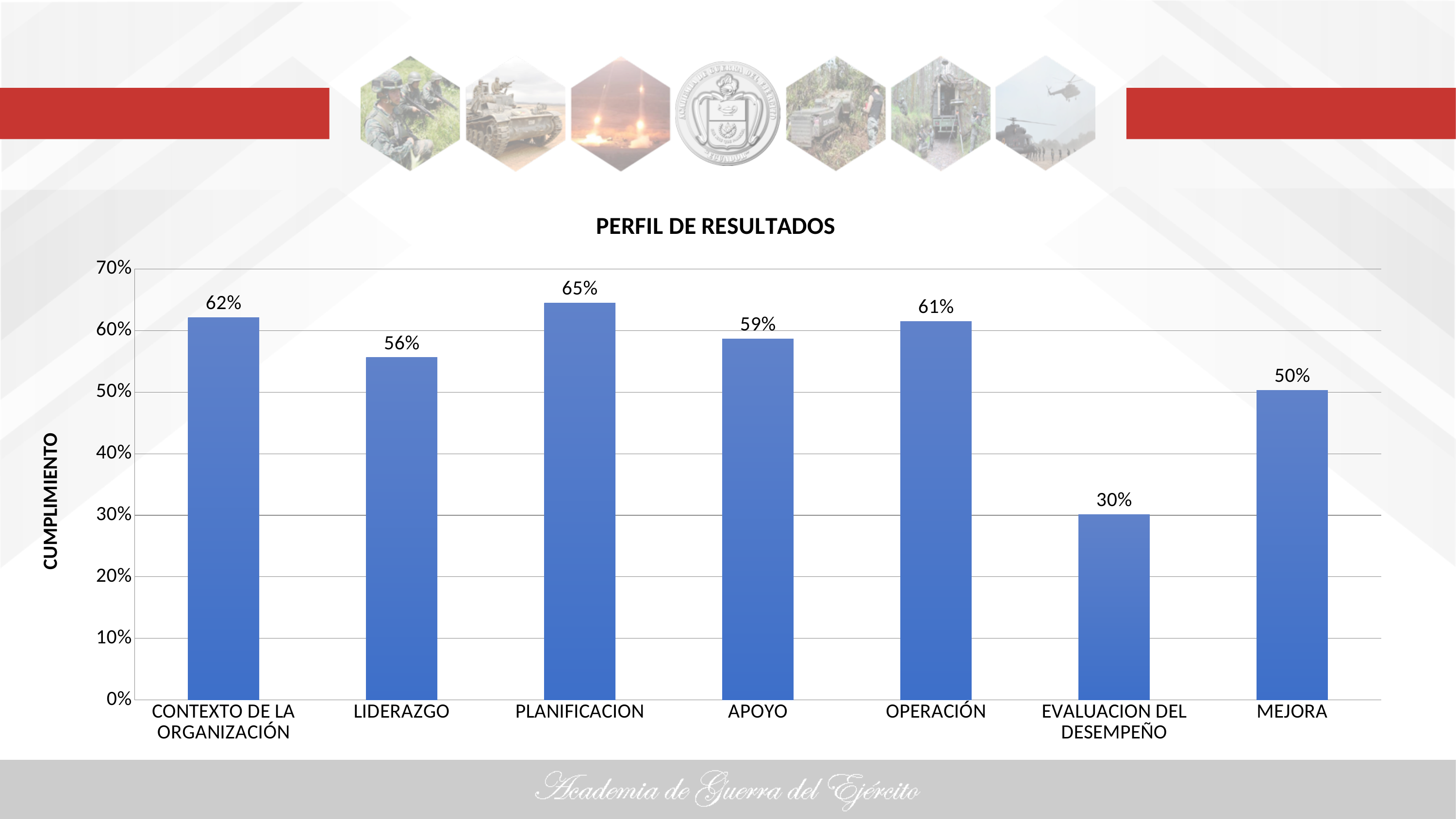
What is the value for PLANIFICACION? 65% What is the value for EVALUACION DEL DESEMPEÑO? 30% Which category has the lowest value? EVALUACION DEL DESEMPEÑO What is the title of the chart? PERFIL DE RESULTADOS What is the difference between the values for CONTEXTO DE LA ORGANIZACIÓN and MEJORA? 12% What kind of chart is shown on the slide? Bar chart Which category has the highest value? PLANIFICACION What is the label of the vertical axis? CUMPLIMIENTO How many categories are shown on the x axis? 7 Which is larger, the value for APOYO or the value for OPERACIÓN? OPERACIÓN What is the value for LIDERAZGO? 56% Is the value for MEJORA greater or less than 40%? greater